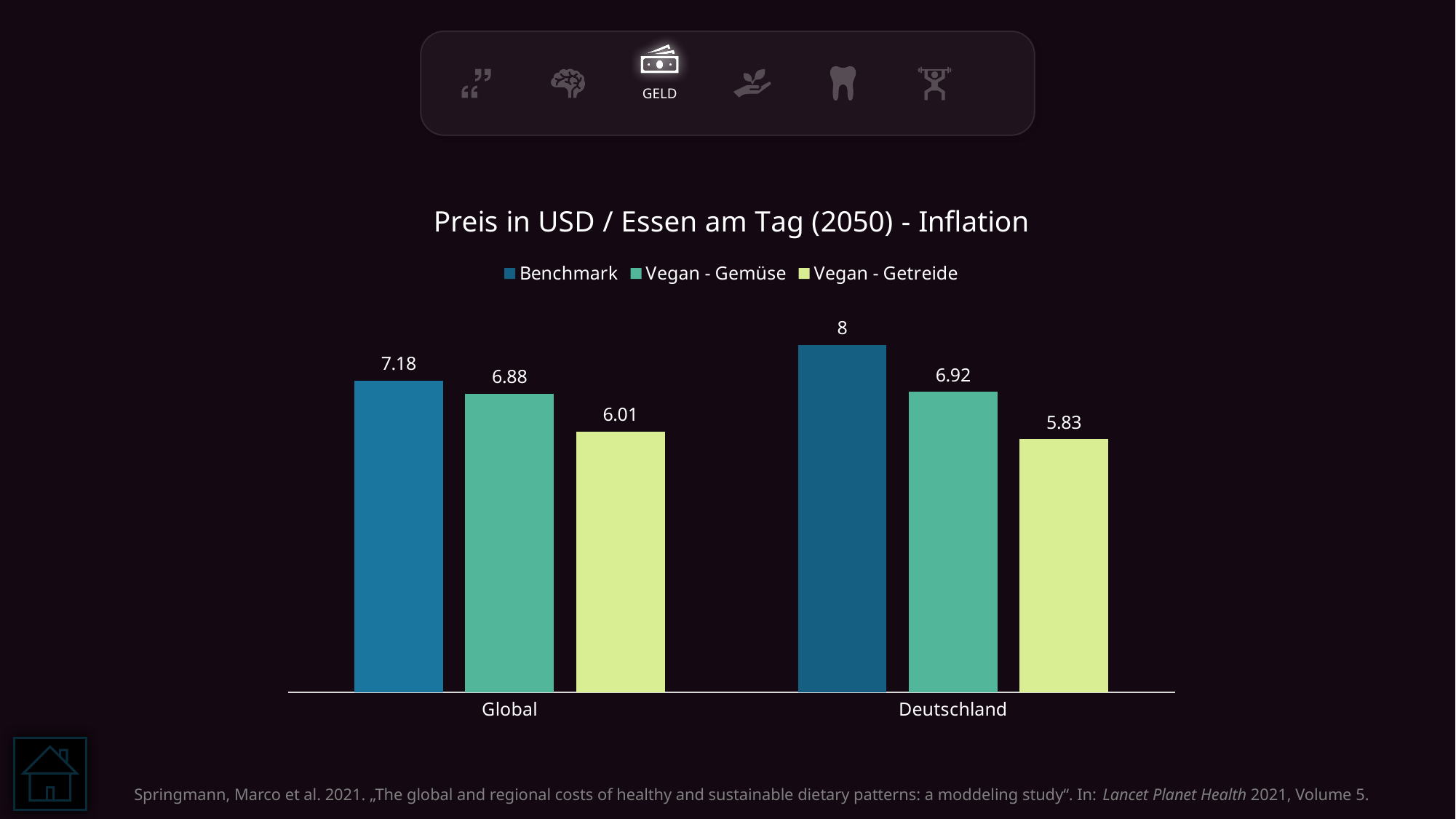
How many series does the legend list? 3 Which series has the lowest value for Global? Vegan - Getreide What is the Vegan - Gemüse value for Global? 6.88 How many categories are shown on the x axis? 2 What is the Benchmark value for Global? 7.18 Which series has the highest value for Deutschland? Benchmark What is the difference between the Benchmark values for Deutschland and Global? 0.82 What is the Vegan - Getreide value for Deutschland? 5.83 Which is larger: the Vegan - Gemüse value for Global or the Vegan - Getreide value for Deutschland? Vegan - Gemüse for Global What kind of chart is shown on the slide? Bar chart What is the difference between the Benchmark and Vegan - Getreide values for Global? 1.17 What is the Benchmark value for Deutschland? 8